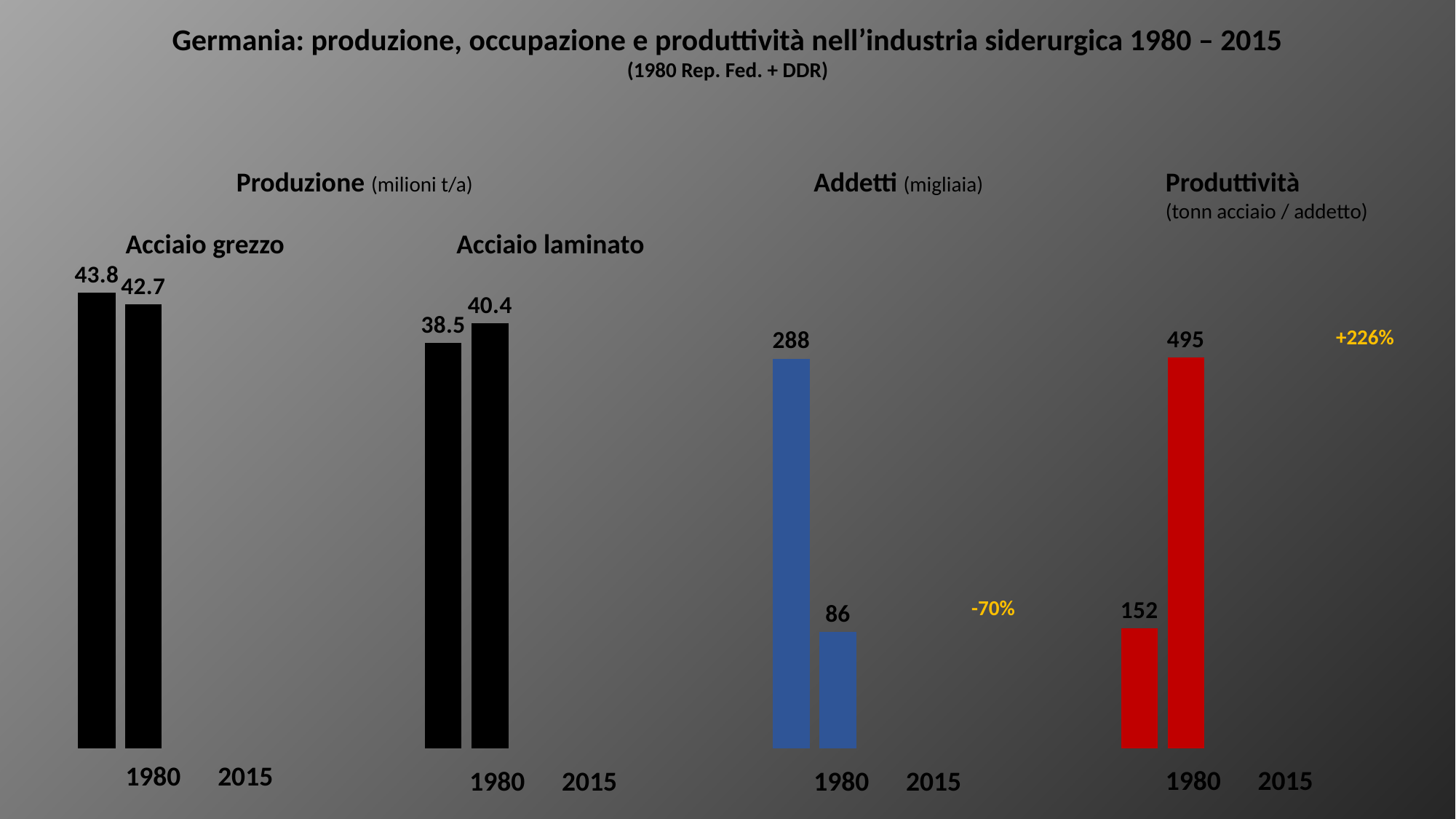
In the Acciaio laminato chart, what is the value of the 2015 bar? 40.4 What kind of chart is used for Produttività? bar chart In the Acciaio grezzo chart, what is the value of the 2015 bar? 42.7 What percentage change is annotated next to the Addetti chart? -70% In the Acciaio grezzo chart, what is the value of the 1980 bar? 43.8 In the Produttività chart, what is the value for 2015? 495 In the Addetti chart, do the values rise or fall from 1980 to 2015? fall In the Addetti chart, what is the difference between the 1980 and 2015 values? 202 In the Produttività chart, what is the difference between the 2015 and 1980 values? 343 In the Acciaio laminato chart, which bar is taller, 1980 or 2015? 2015 In the Addetti chart, what is the value for 1980? 288 What colour are the bars in the Addetti chart? blue